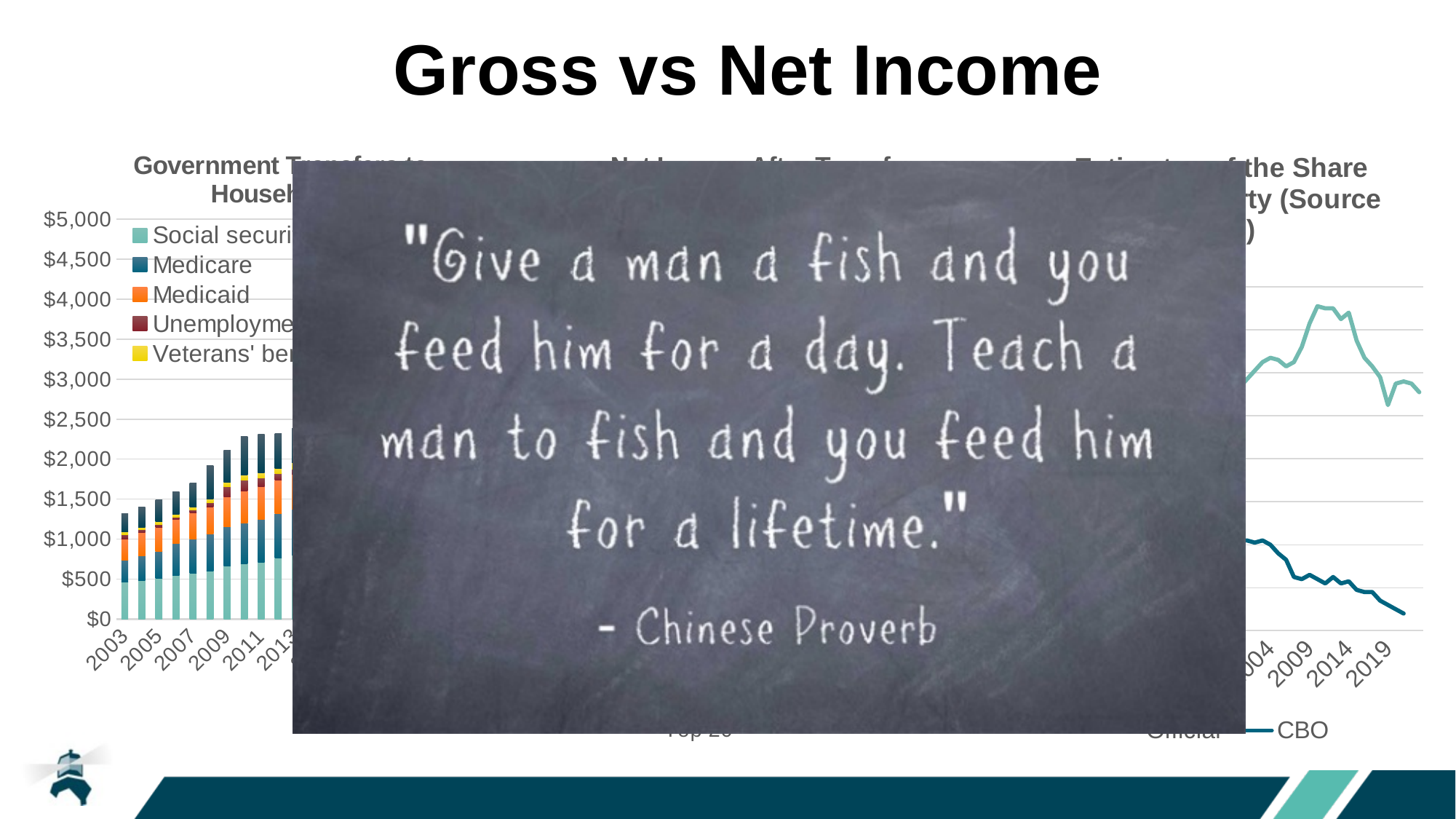
In the left bar chart, which series forms the bottom segment of each stacked bar? Social security What kind of chart is the chart on the right of the slide? line chart In the left bar chart, is the total for 2011 greater or less than $3,000? less In the left bar chart, is the total for 2003 greater or less than $1,000? greater What kind of chart is the chart on the left of the slide? bar chart In the right line chart, does the CBO line rise or fall from 2004 to 2019? fall In the left bar chart, is the total for 2003 greater or less than $1,500? less In the left bar chart, which series is shown in orange? Medicaid In the right line chart, which series is plotted higher on the chart, Official or CBO? Official In the left bar chart, do the total bar heights rise or fall from 2003 to 2011? rise